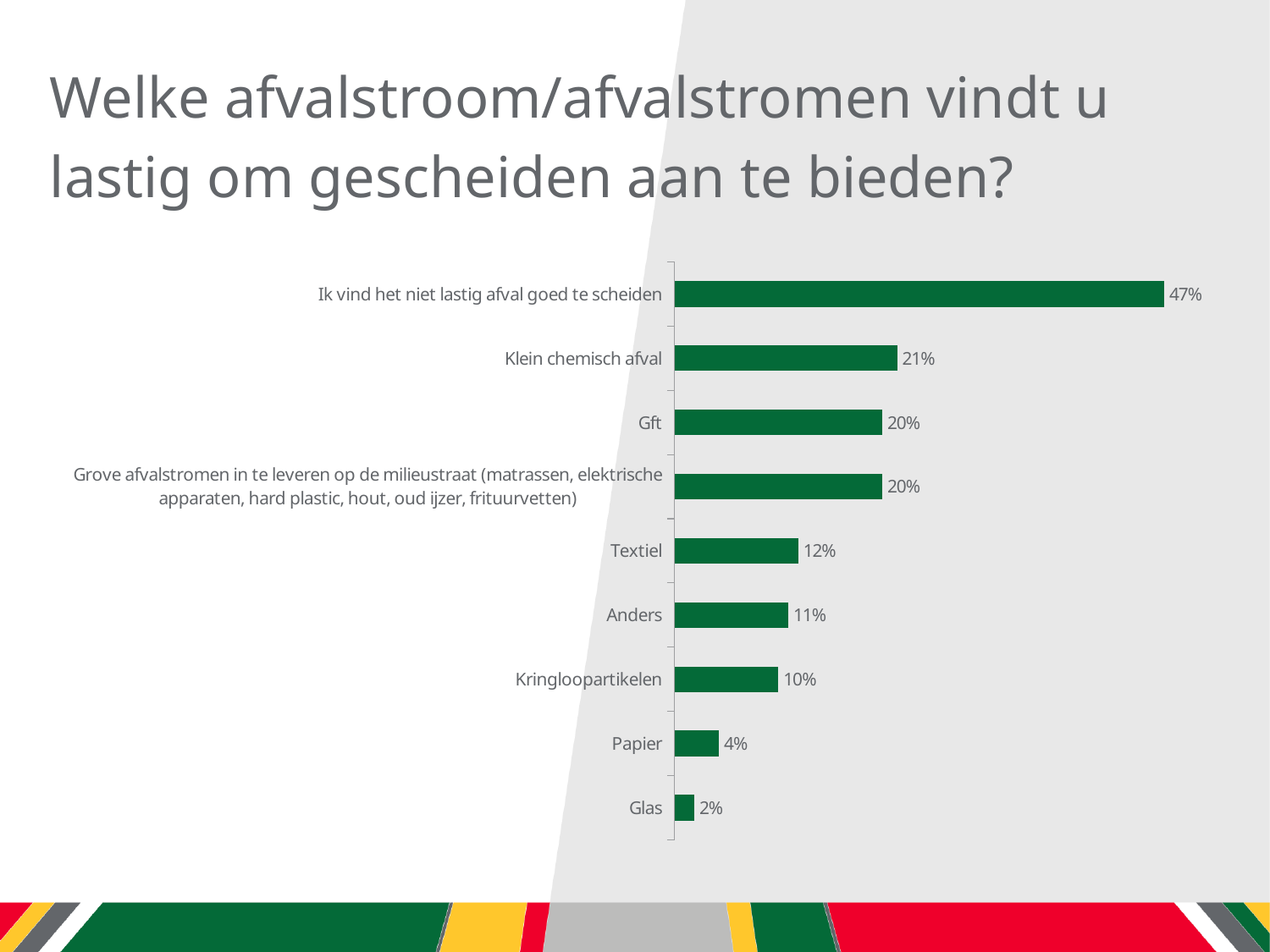
What is the value for Glas? 2% What colour are the bars in the chart? Green Which is larger, the value for Anders or the value for Kringloopartikelen? Anders What kind of chart is shown on the slide? Bar chart What is the value for Kringloopartikelen? 10% Which category has the lowest value? Glas What is the value for Klein chemisch afval? 21% How many categories are shown in the chart? 9 What is the difference between the values for Gft and Textiel? 8% What is the difference between the values for Klein chemisch afval and Papier? 17% Which category has the highest value? Ik vind het niet lastig afval goed te scheiden What is the value for Textiel? 12%